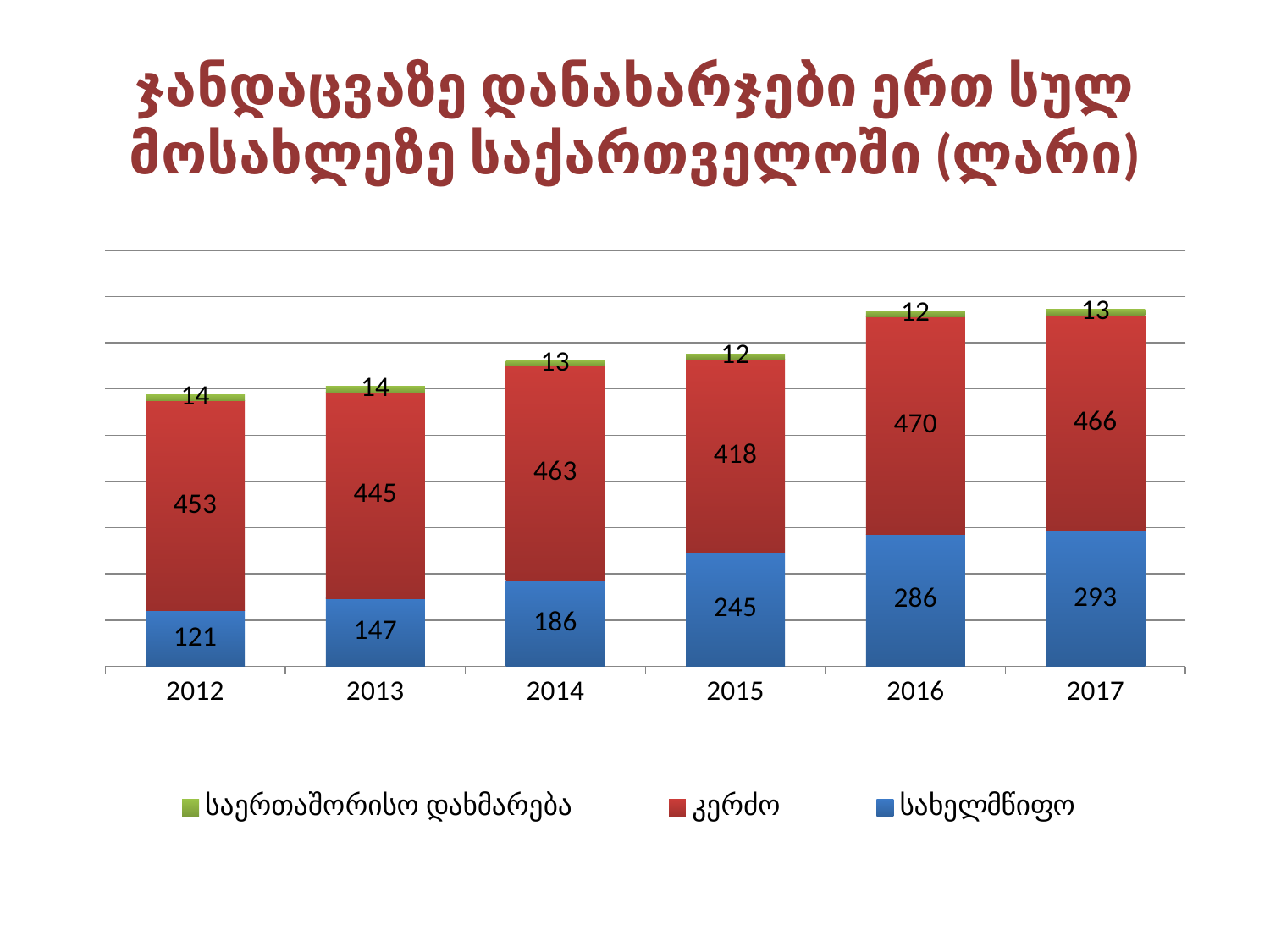
What is the total of the stacked bar for 2012? 588 How many series does the legend list? 3 How many years are shown on the x axis? 6 What is the value of the სახელმწიფო (blue) segment for 2014? 186 What is the value of the საერთაშორისო დახმარება (green) segment for 2015? 12 What is the difference between the სახელმწიფო (blue) values for 2017 and 2012? 172 In which year is the სახელმწიფო (blue) segment the highest? 2017 Which is larger, the კერძო (red) value for 2014 or for 2013? 2014 In which year is the კერძო (red) segment the lowest? 2015 Does the სახელმწიფო (blue) segment rise or fall from 2012 to 2017? rise What is the value of the კერძო (red) segment for 2016? 470 What type of chart is shown on the slide? stacked bar chart